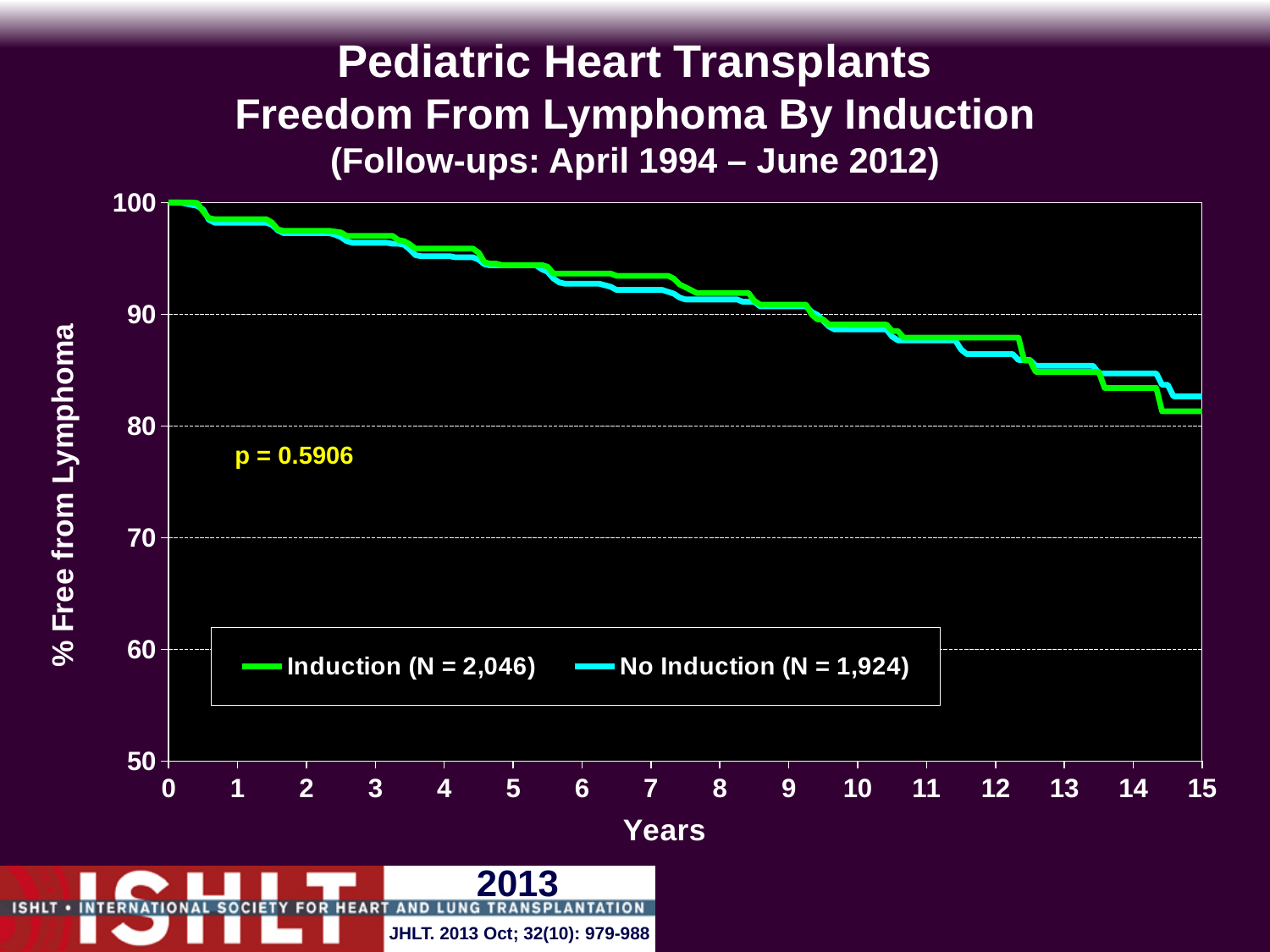
How many series does the legend list? 2 What is the N for the Induction group shown in the legend? 2,046 Do the values for the Induction series rise or fall as years increase? fall Is the value for No Induction at year 3 greater or less than 90? greater Is the value for Induction at year 12 greater or less than 90? less Is the value for No Induction at year 15 greater or less than 80? greater At year 15, which series has the higher value, Induction or No Induction? No Induction What is the p-value shown on the chart? p = 0.5906 What kind of chart is shown on the slide? line chart What is the value of the No Induction series at year 0? 100